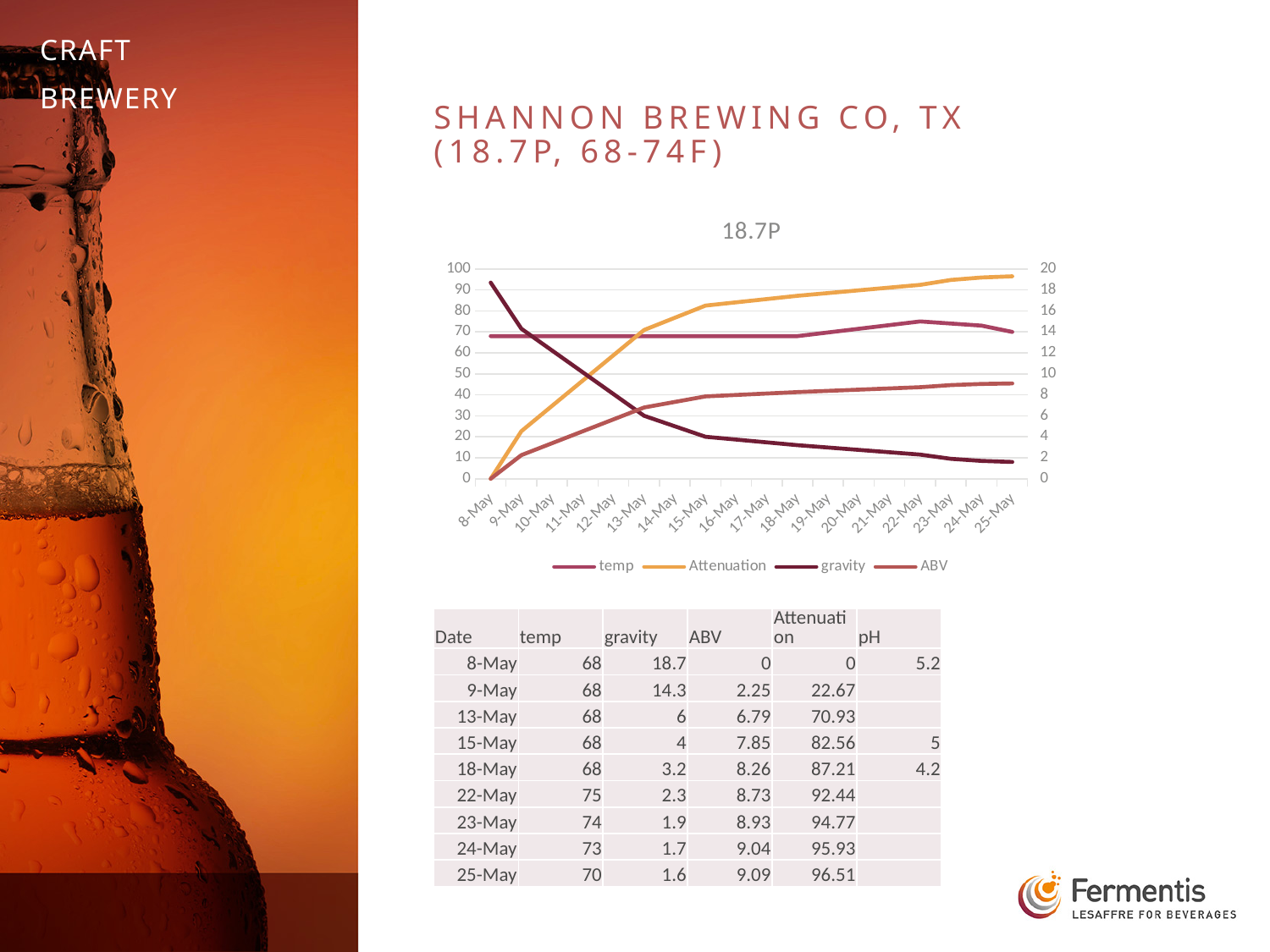
How many series does the chart legend list? 4 According to the table below the chart, what is the difference between temp on 22-May and temp on 25-May? 5 Is the temp value on 8-May greater or less than 60 on the left axis? greater Does the Attenuation line rise or fall from 8-May to 25-May? rise According to the table below the chart, what is the ABV on 25-May? 9.09 According to the table below the chart, on which date is temp highest? 22-May Is the Attenuation value on 25-May greater or less than 90 on the left axis? greater What is the title of the chart? 18.7P How many dates are shown along the x axis of the chart? 18 Which series are listed in the chart legend? temp, Attenuation, gravity, ABV Does the gravity line rise or fall from 8-May to 25-May? fall What kind of chart is shown on the slide? line chart